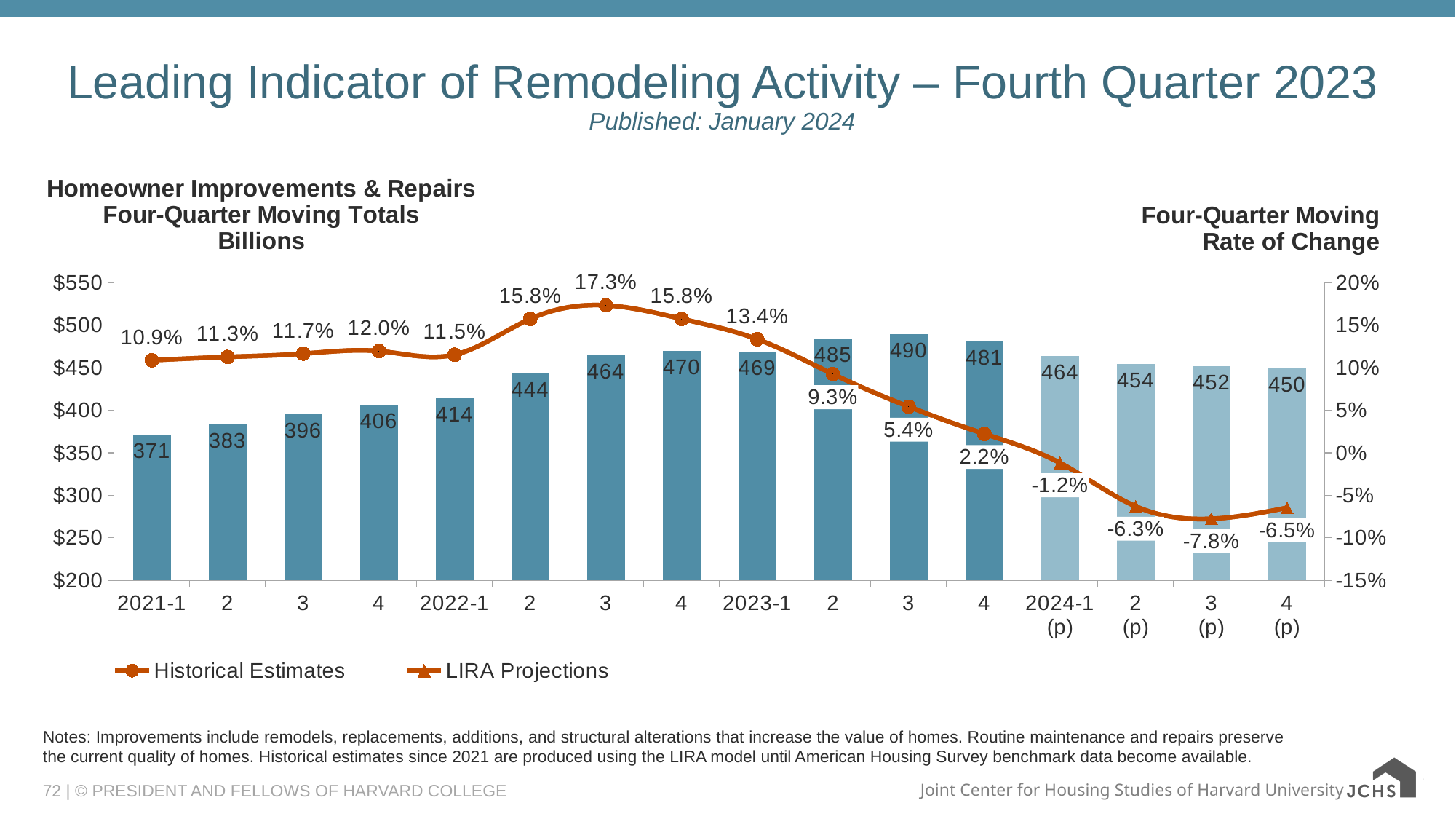
Which is larger, the four-quarter moving total for 2022-4 or for 2023-1? 2022-4 Does the four-quarter moving rate of change rise or fall from 2022-3 to 2024-3 (p)? fall What is the four-quarter moving total for 2023-3? 490 What is the projected four-quarter moving total for 2024-4 (p)? 450 How many quarters are shown on the x axis? 16 Which quarter has the lowest four-quarter moving total? 2021-1 What is the four-quarter moving rate of change for 2022-3? 17.3% Which quarter has the lowest four-quarter moving rate of change? 2024-3 (p) What is the projected rate of change for 2024-3 (p)? -7.8% Which quarter has the highest four-quarter moving total? 2023-3 How many series does the legend list? 2 What is the difference between the four-quarter moving totals for 2023-3 and 2021-1? 119